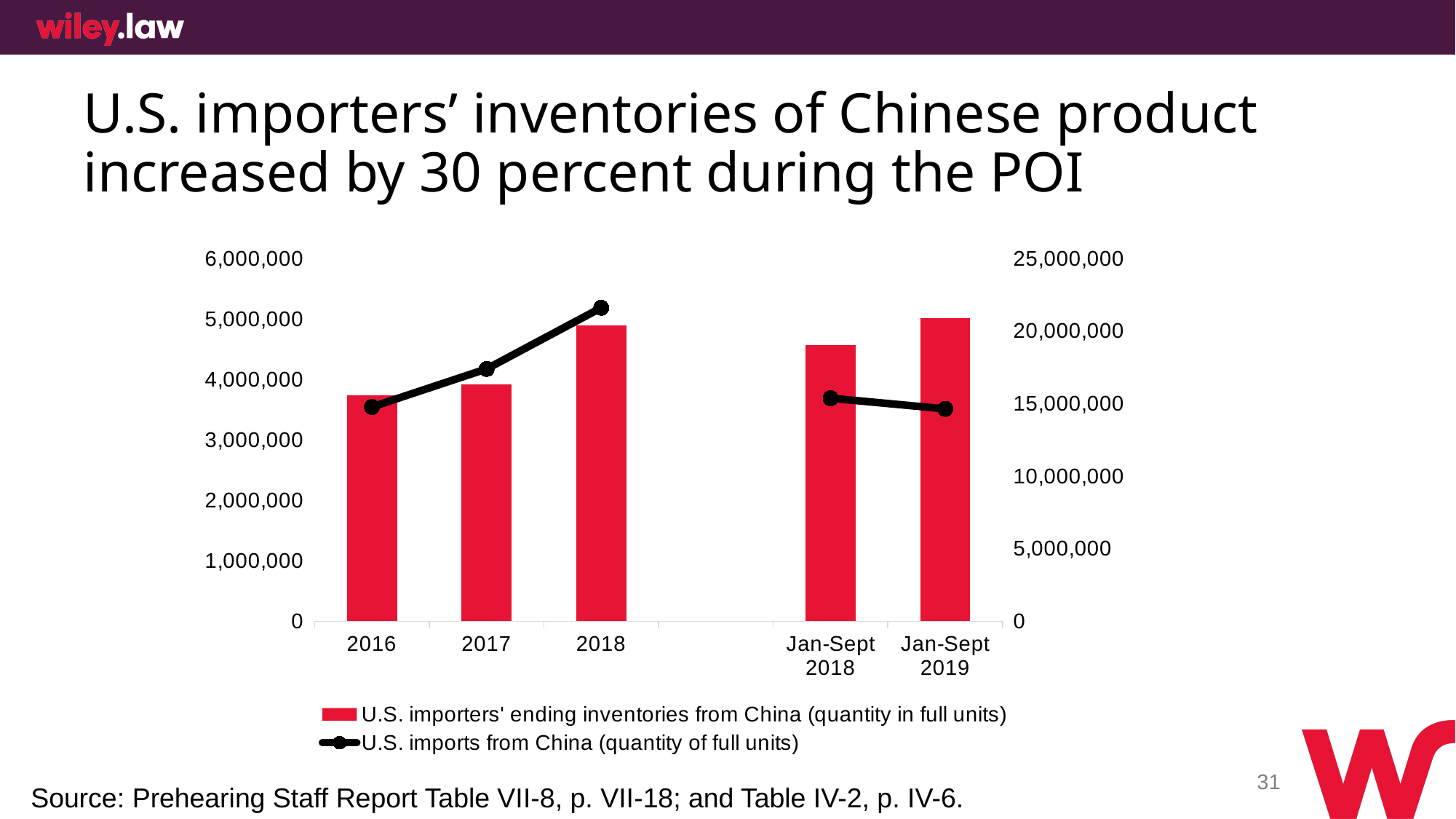
How many categories are shown on the x axis of the chart? 5 Is the value of U.S. imports from China for 2017 greater or less than 15,000,000 on the right axis? greater How many series does the chart's legend list? 2 Is the value of U.S. importers' ending inventories from China for 2016 greater or less than 4,000,000? less Is the value of U.S. importers' ending inventories from China for Jan-Sept 2018 greater or less than 5,000,000? less Do U.S. importers' ending inventories from China rise or fall from 2016 to 2018? rise Among the full years 2016, 2017 and 2018, which year has the highest U.S. importers' ending inventories from China? 2018 What kind of chart is shown on the slide? A combination bar and line chart Does the U.S. imports from China line rise or fall from Jan-Sept 2018 to Jan-Sept 2019? fall Which year has the highest value of U.S. imports from China on the line series? 2018